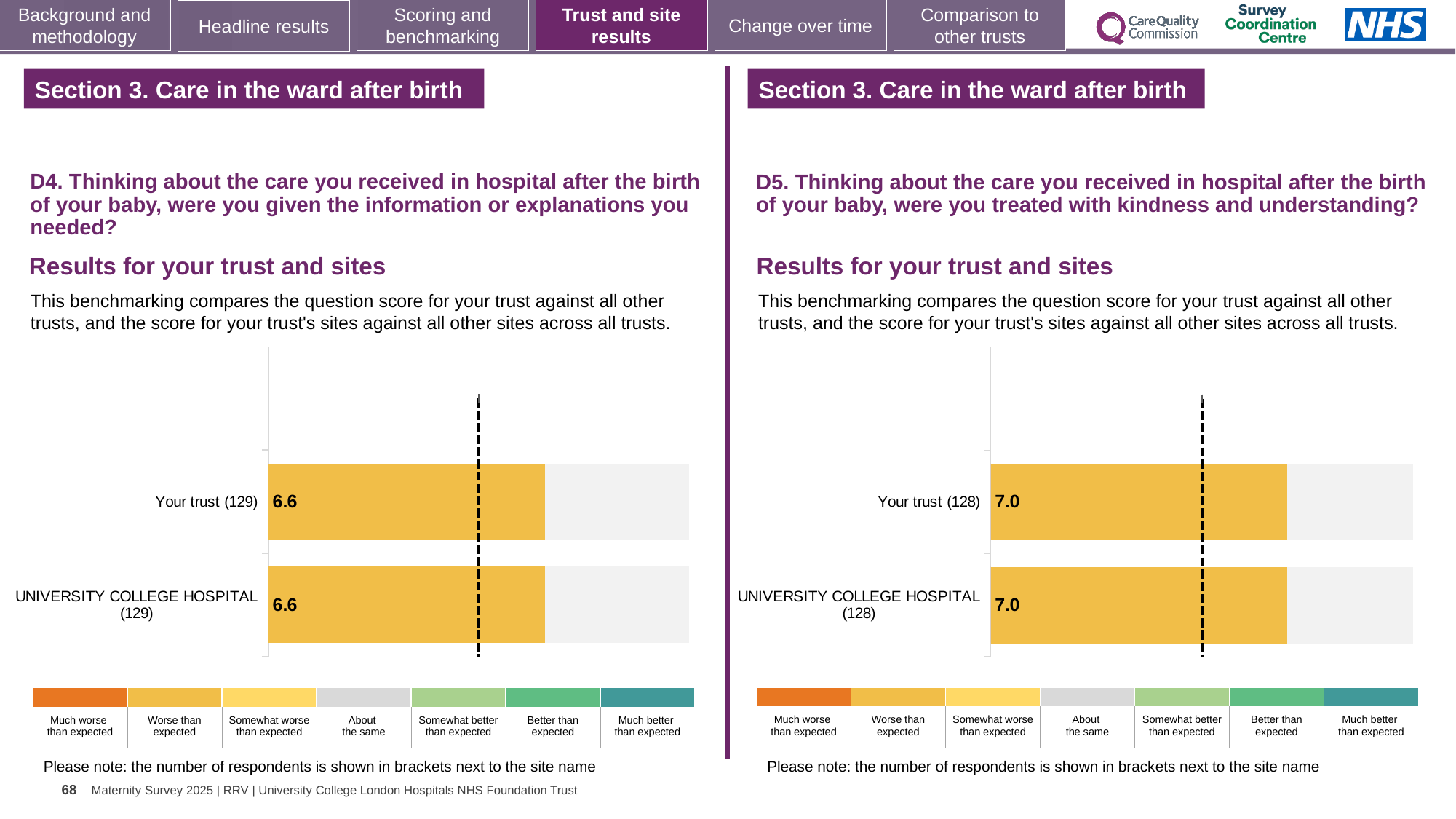
How many categories does the colour legend below the D5 chart on the right list? 7 How many bars are plotted in the D4 chart on the left? 2 How many bars are plotted in the D5 chart on the right? 2 In the D5 chart on the right, how many respondents are shown in brackets for UNIVERSITY COLLEGE HOSPITAL? 128 In the D4 chart on the left, what is the difference between the score for Your trust and the score for UNIVERSITY COLLEGE HOSPITAL? 0.0 In the D4 chart on the left, what is the score for Your trust? 6.6 In the D4 chart on the left, how many respondents are shown in brackets for Your trust? 129 In the D5 chart on the right, what is the score for Your trust? 7.0 In the D5 chart on the right, what is the difference between the score for Your trust and the score for UNIVERSITY COLLEGE HOSPITAL? 0.0 In the D5 chart on the right, what is the score for UNIVERSITY COLLEGE HOSPITAL? 7.0 In the D4 chart on the left, what is the score for UNIVERSITY COLLEGE HOSPITAL? 6.6 What type of chart is used for the D4 results on the left? Bar chart